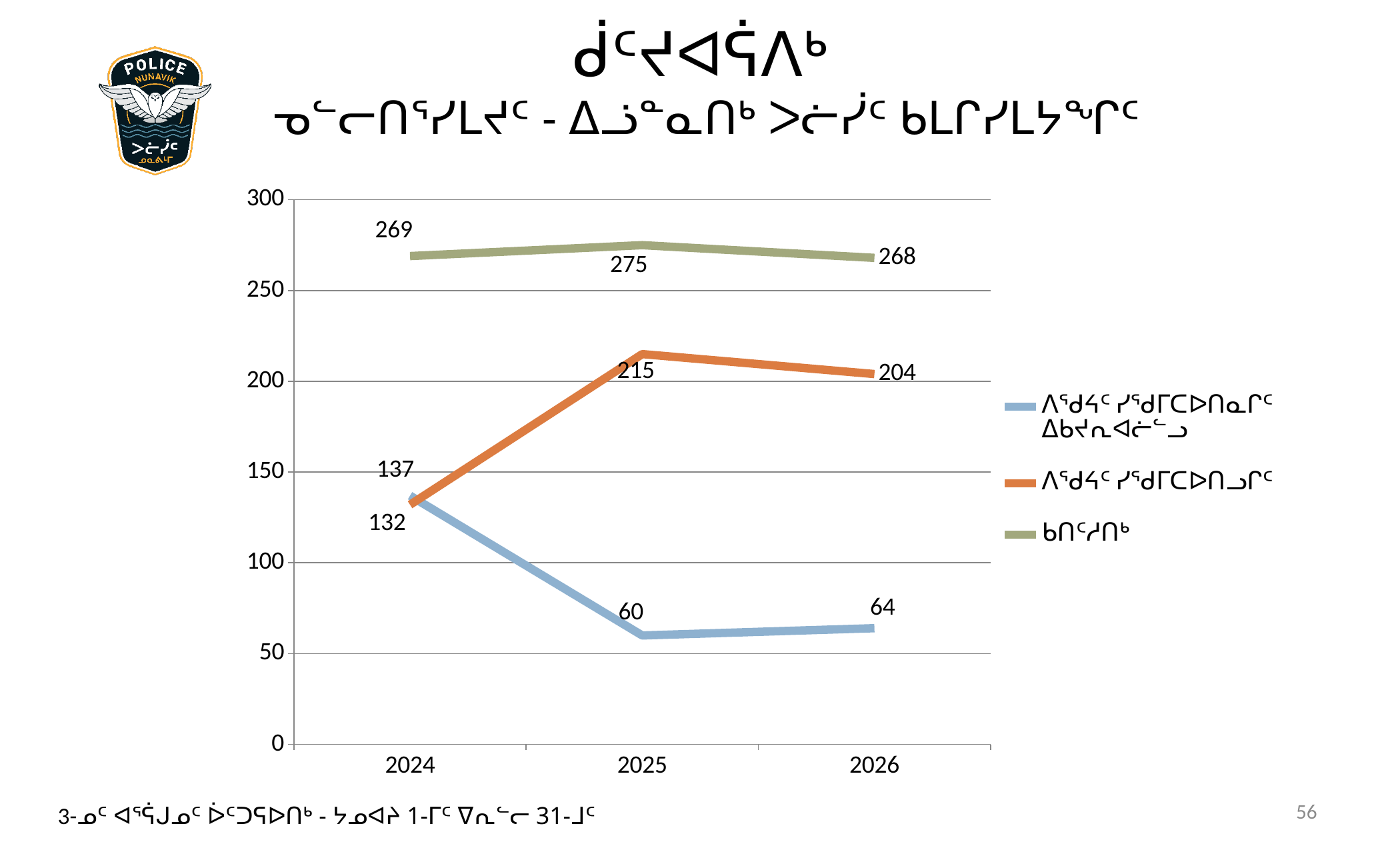
Which line has the larger value in 2026, the orange line or the blue line? orange In which year does the green line reach its highest value? 2025 What is the value of the orange line in 2026? 204 Is the value of the green line in 2024 greater or less than 250? greater How many years are shown on the x axis of the chart? 3 Does the blue line rise or fall from 2024 to 2025? fall What is the difference between the orange line's values in 2025 and 2024? 83 How many series does the chart legend list? 3 In which year does the blue line have its lowest value? 2025 What type of chart is shown on the slide? line chart What is the value of the green line in 2025? 275 What is the value of the blue line in 2025? 60